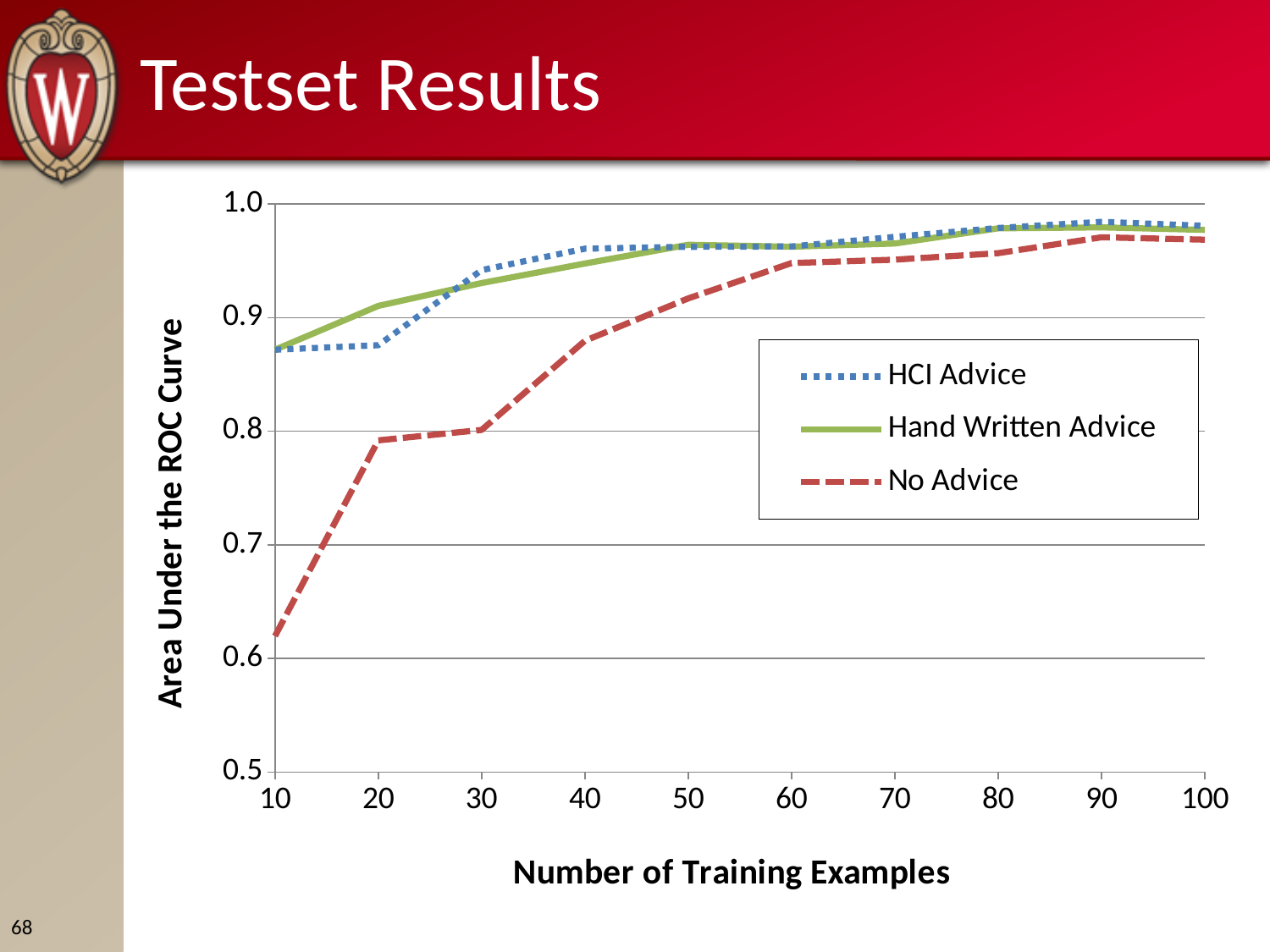
At 20 training examples, which is larger: Hand Written Advice or HCI Advice? Hand Written Advice Is the value for No Advice at 10 training examples greater or less than 0.6? greater Is the value for HCI Advice at 10 training examples greater or less than 0.9? less Does the No Advice line rise or fall as the number of training examples increases from 10 to 60? rise Is the value for No Advice at 60 training examples greater or less than 0.9? greater How many series does the legend list? 3 What kind of chart is shown on the slide? line chart How many training-example values are marked along the x axis? 10 Which series has the lowest value at 10 training examples? No Advice